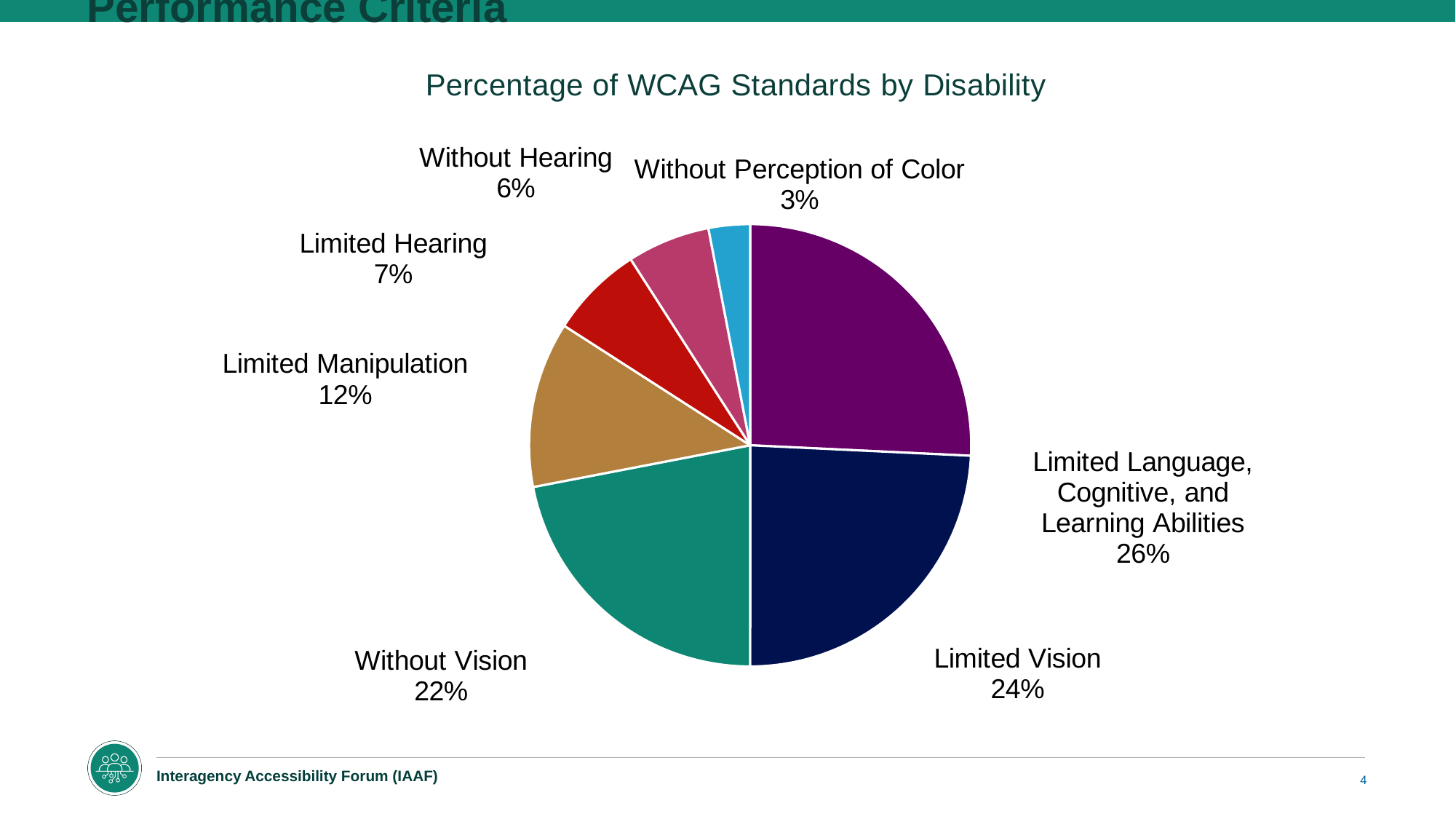
What percentage is shown for Limited Vision? 24% What is the title of the chart? Percentage of WCAG Standards by Disability What is the difference in percentage points between Limited Vision and Without Vision? 2 What is the combined percentage of Limited Hearing and Without Hearing? 13% What percentage is shown for Without Perception of Color? 3% Which category has the largest share of the pie? Limited Language, Cognitive, and Learning Abilities What percentage is shown for Limited Manipulation? 12% What kind of chart is shown on the slide? pie chart What colour is the slice for Without Vision? teal Which category has the smallest share of the pie? Without Perception of Color How many categories are shown in the pie chart? 7 Which is larger, the share for Limited Hearing or the share for Without Hearing? Limited Hearing